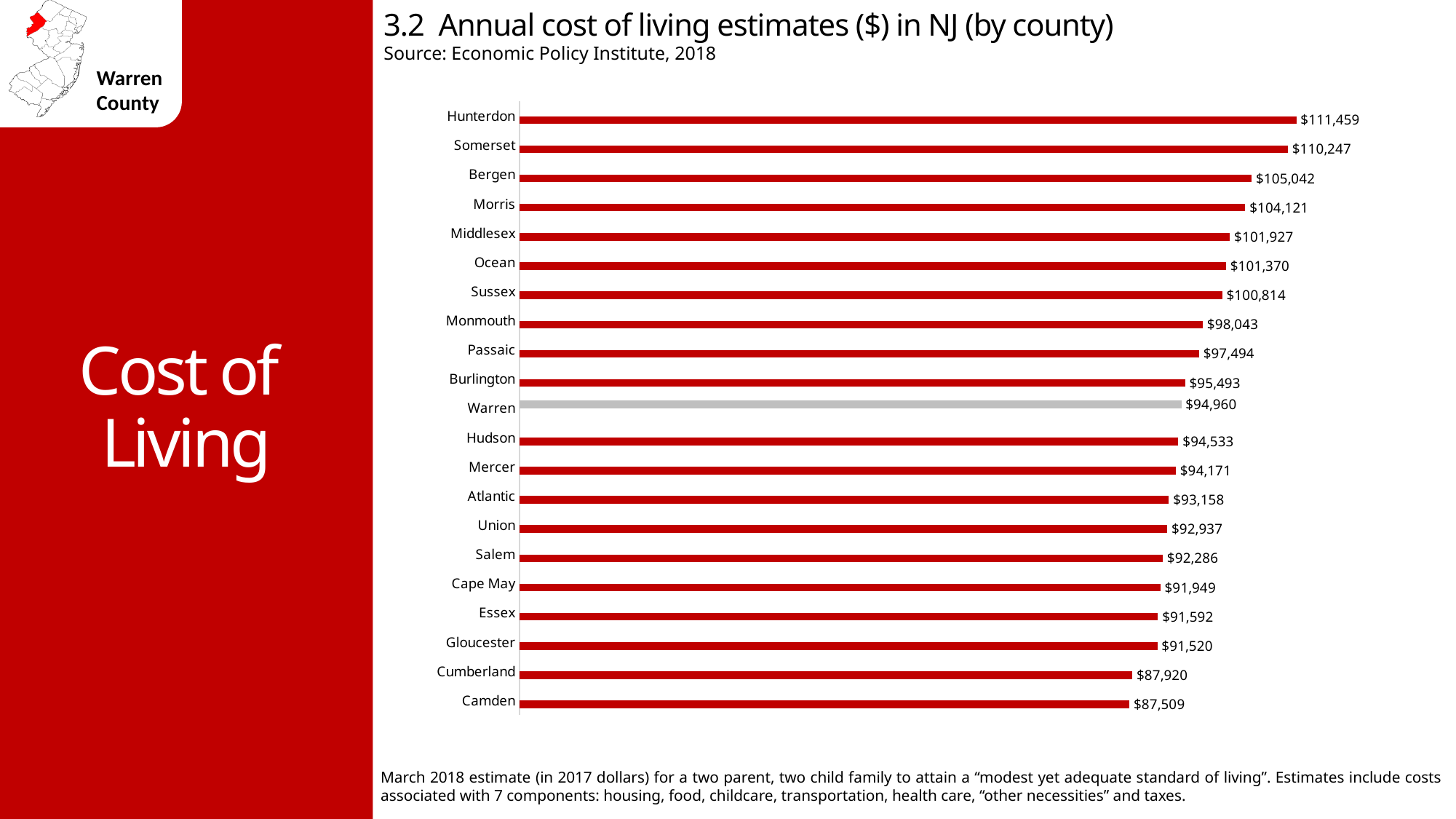
What kind of chart is shown on the slide? Bar chart What is the annual cost of living estimate for Hunterdon County? $111,459 Which county has the highest annual cost of living estimate? Hunterdon What is the difference between the cost of living estimates for Warren and Hudson? $427 Which county's bar is coloured grey instead of red? Warren Which county has the lowest annual cost of living estimate? Camden What is the annual cost of living estimate for Warren County? $94,960 Which has a higher cost of living estimate, Bergen or Morris? Bergen What is the difference between the cost of living estimates for Hunterdon and Camden? $23,950 What is the source cited for the chart? Economic Policy Institute, 2018 How many counties are shown in the chart? 21 What is the annual cost of living estimate for Camden County? $87,509